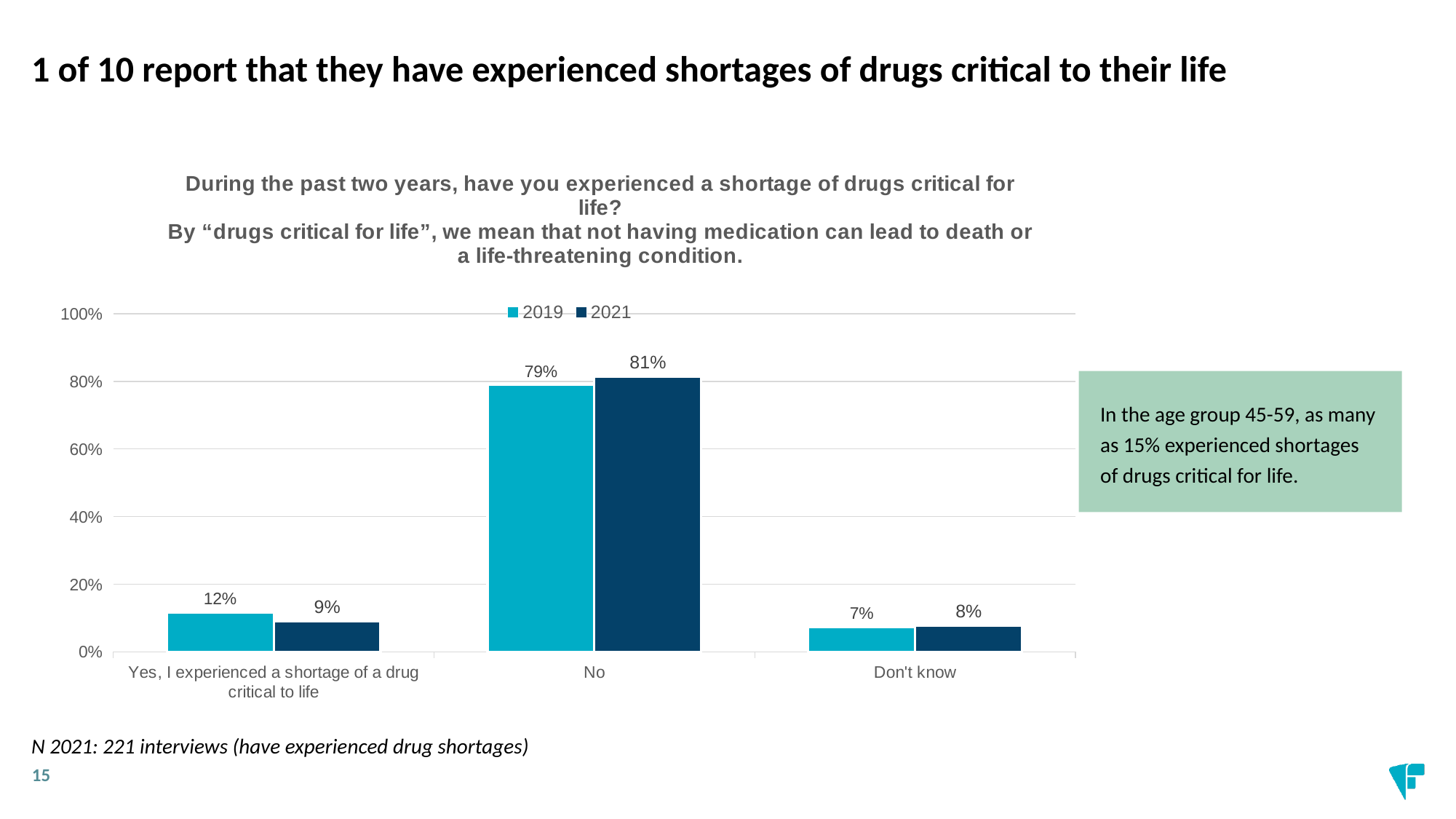
How many categories are shown on the x axis? 3 Which category has the highest value in the 2021 series? No What is the difference between the 2019 and 2021 values for "Yes, I experienced a shortage of a drug critical to life"? 3% What is the 2019 value for "No"? 79% Is the 2021 value for "No" greater or less than 80%? greater What is the 2021 value for "No"? 81% Which is larger for "No": the 2019 value or the 2021 value? 2021 Which category has the lowest value in the 2019 series? Don't know How many series does the legend list? 2 What is the 2021 value for "Don't know"? 8% What kind of chart is shown on the slide? Bar chart What is the 2019 value for "Yes, I experienced a shortage of a drug critical to life"? 12%